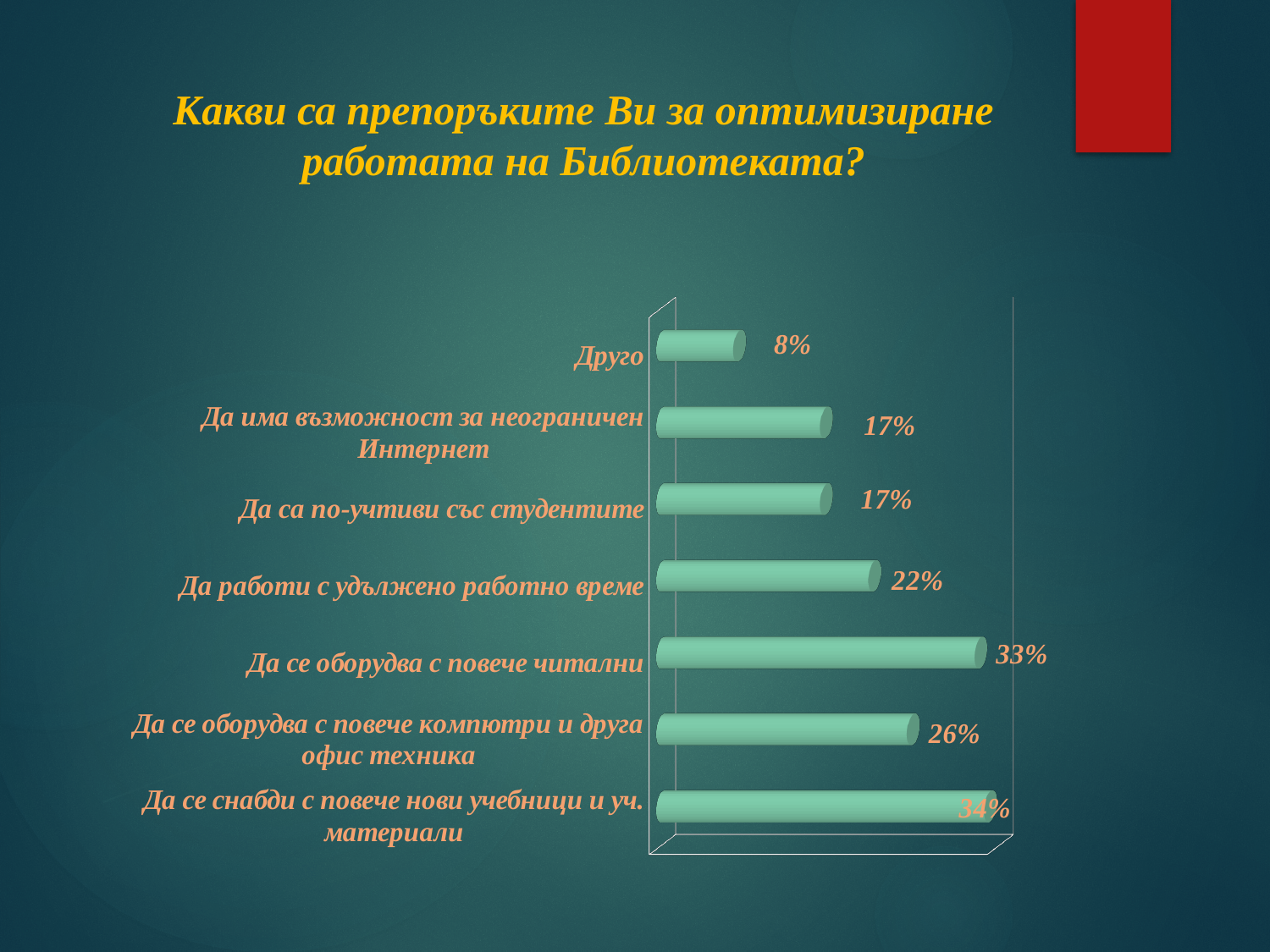
What is the difference between the values for "Да се снабди с повече нови учебници и уч. материали" and "Друго"? 26% What kind of chart is shown on the slide? Bar chart What is the value for "Да работи с удължено работно време"? 22% What is the difference between the values for "Да се оборудва с повече читални" and "Да работи с удължено работно време"? 11% Which category has the lowest value? Друго Which category has the highest value? Да се снабди с повече нови учебници и уч. материали Which is larger: the value for "Да се оборудва с повече компютри и друга офис техника" or for "Да са по-учтиви със студентите"? Да се оборудва с повече компютри и друга офис техника What percentage is shown for "Друго"? 8% How many categories are shown in the chart? 7 What is the value for "Да се оборудва с повече компютри и друга офис техника"? 26% What percentage is shown for "Да има възможност за неограничен Интернет"? 17% What percentage is shown for "Да се оборудва с повече читални"? 33%